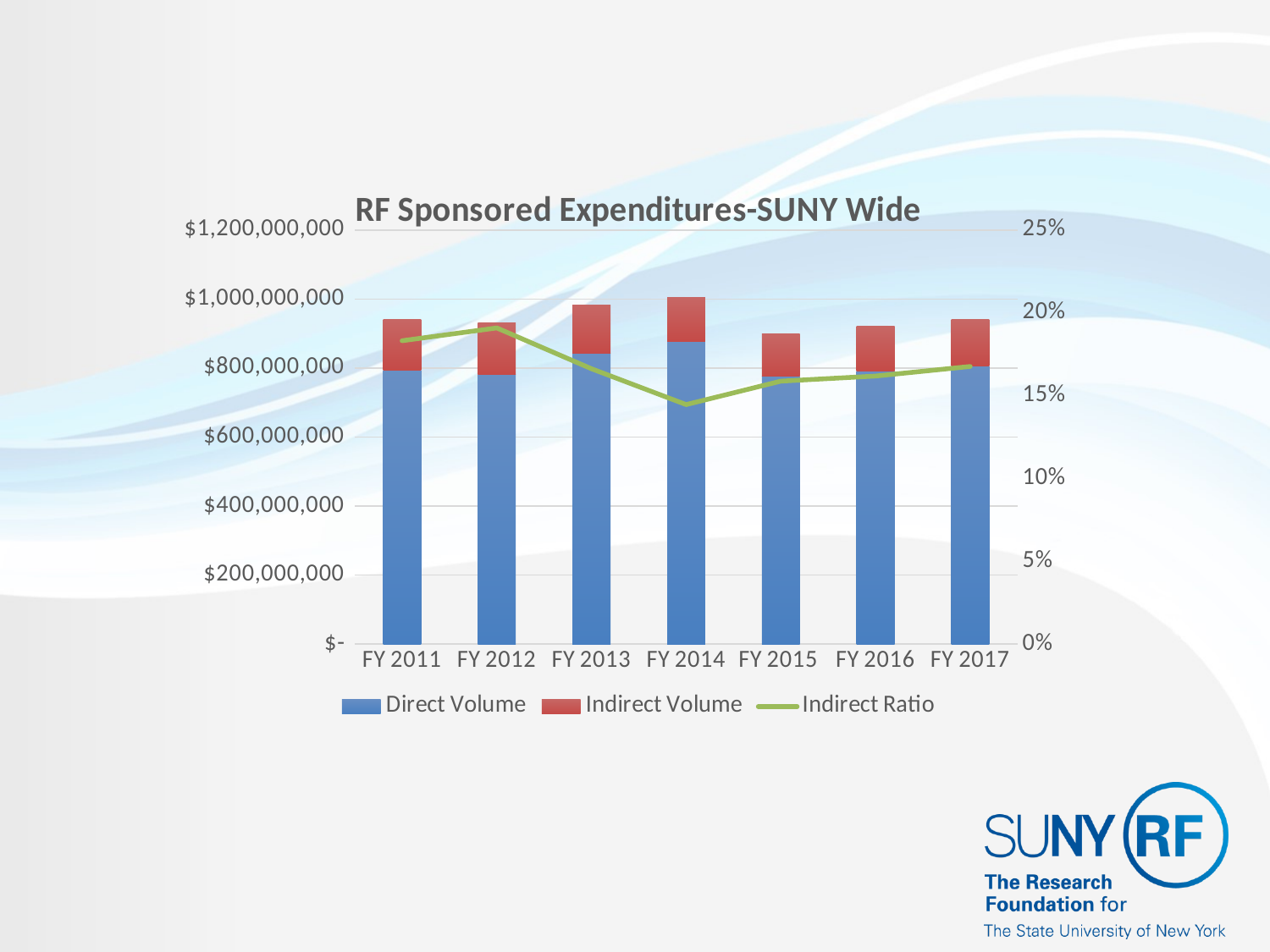
What is the title of the chart? RF Sponsored Expenditures-SUNY Wide Which series is plotted as a line? Indirect Ratio How many series does the legend list? 3 Is the Direct Volume for FY 2014 greater or less than $800,000,000? greater In which fiscal year is the Indirect Ratio highest? FY 2012 In which fiscal year is the Indirect Ratio lowest? FY 2014 What kind of chart is shown on the slide? Stacked bar chart with a line Which fiscal year has the tallest total bar? FY 2014 Which total bar is taller, FY 2014 or FY 2015? FY 2014 Is the total bar for FY 2015 greater or less than $1,000,000,000? less Is the Indirect Ratio for FY 2012 greater or less than 20%? less How many fiscal years are shown on the x axis? 7